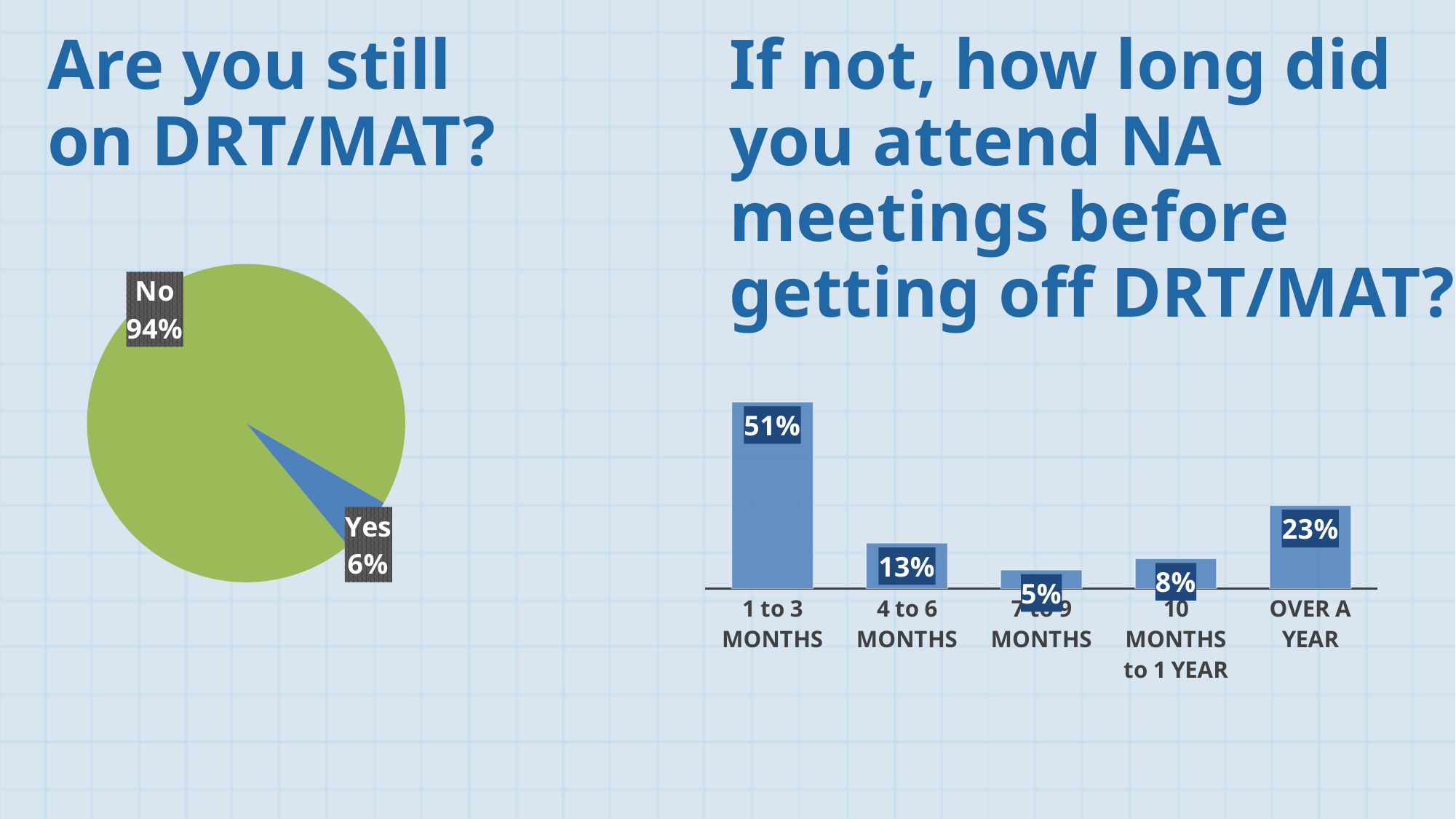
In the bar chart on the right, what is the difference between the values for 1 to 3 months and over a year? 28% In the pie chart on the left, what percentage answered "No"? 94% In the pie chart on the left, how many slices are there? 2 In the bar chart on the right, which is larger: the value for 4 to 6 months or the value for 10 months to 1 year? 4 to 6 months What kind of chart is the chart on the left of the slide? Pie chart What kind of chart is the chart on the right of the slide? Bar chart In the bar chart on the right, which category has the highest value? 1 to 3 months In the bar chart on the right, which category has the lowest value? 7 to 9 months In the bar chart on the right, what is the value for 1 to 3 months? 51% In the bar chart on the right, what is the value for over a year? 23% In the pie chart on the left, what percentage answered "Yes"? 6% In the pie chart on the left, which answer has the larger share? No